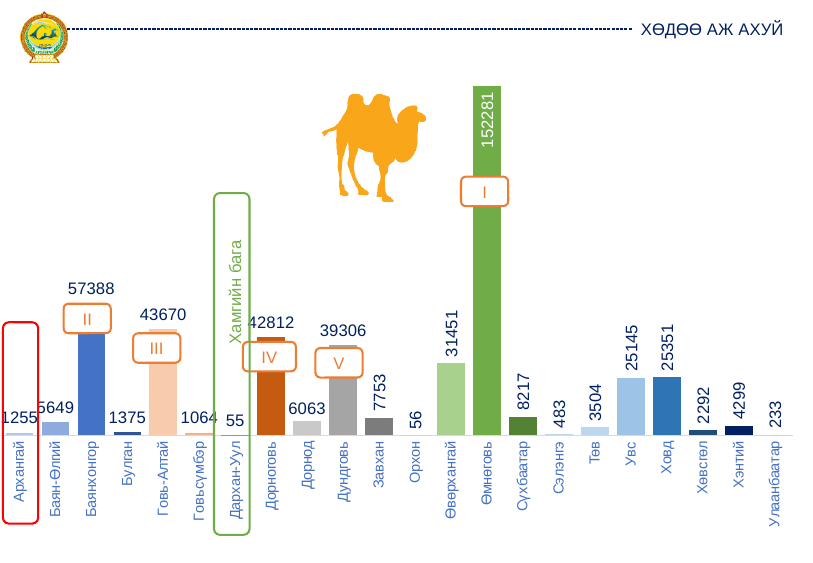
What is the value shown for Өмнөговь? 152281 What kind of chart is shown on the slide? bar chart Which is larger, the value for Дорноговь or the value for Дундговь? Дорноговь Which category is marked with the rank label "II"? Баянхонгор What is the difference between the values for Өмнөговь and Баянхонгор? 94893 What is the value shown for Дархан-Уул? 55 Which category has the lowest value? Дархан-Уул How many categories are shown on the x axis? 22 Which category has the highest value? Өмнөговь What is the difference between the values for Баянхонгор and Говь-Алтай? 13718 What is the value shown for Баянхонгор? 57388 What is the value shown for Увс? 25145